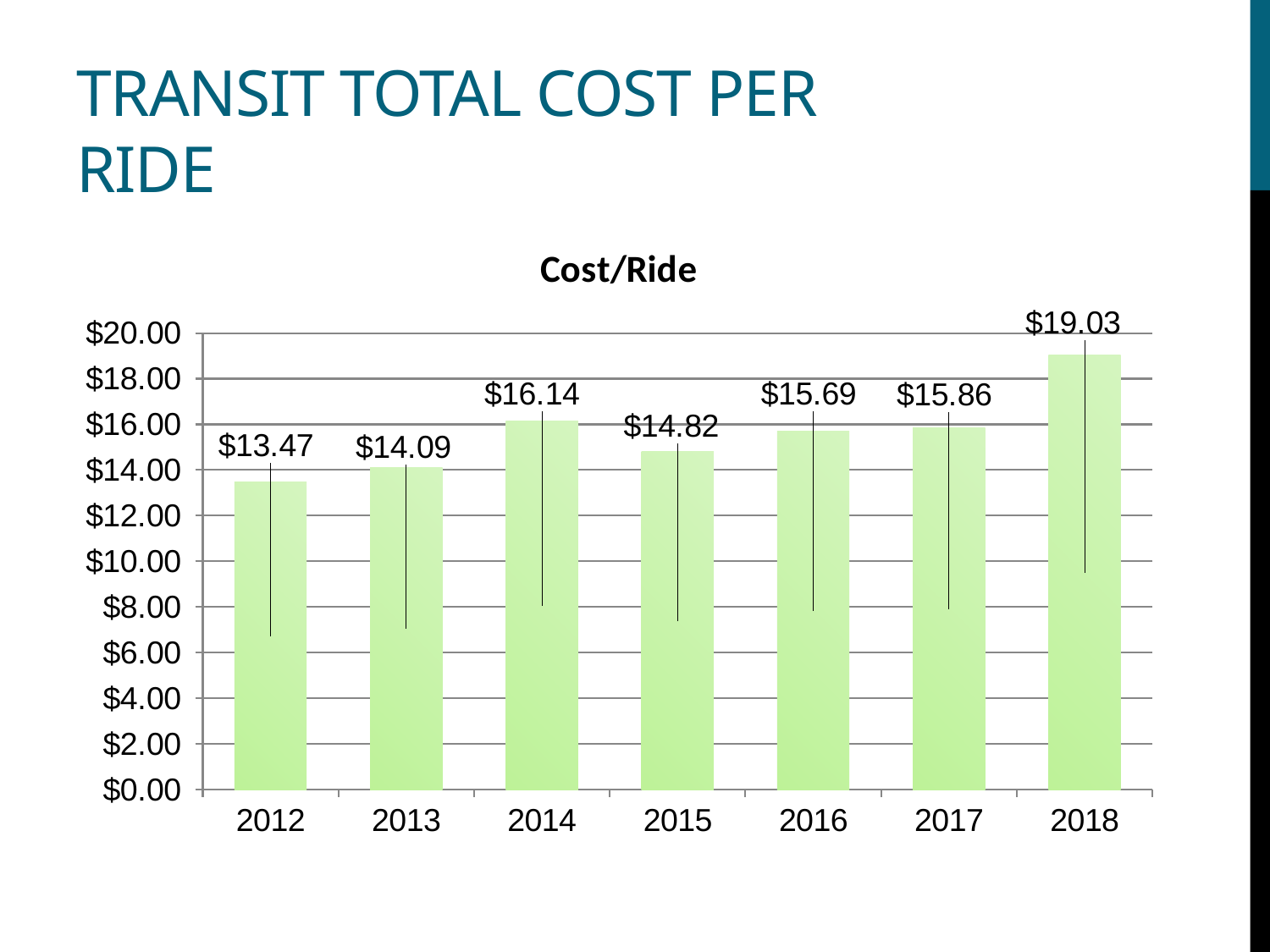
How many years are shown on the chart? 7 Which year has the highest cost per ride? 2018 What is the difference in cost per ride between 2018 and 2017? $3.17 Is the cost per ride in 2013 greater or less than $16.00? less Which year has a higher cost per ride, 2014 or 2016? 2014 Which year has the lowest cost per ride? 2012 What is the title of the chart? Cost/Ride What is the cost per ride in 2018? $19.03 What is the difference in cost per ride between 2014 and 2015? $1.32 What is the cost per ride in 2015? $14.82 What is the cost per ride in 2012? $13.47 What type of chart is shown on the slide? bar chart